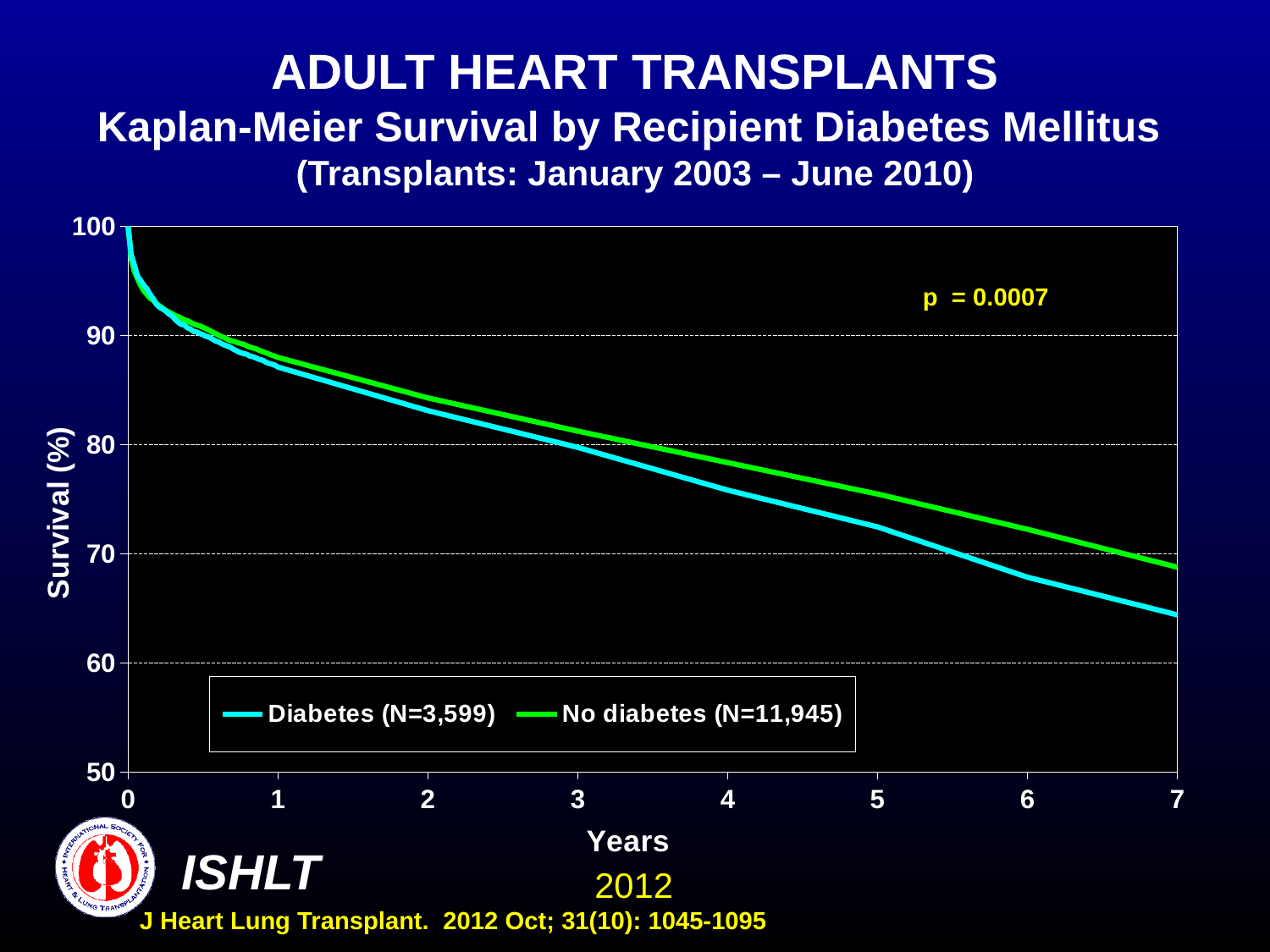
How many series does the legend list? 2 Is the survival for the Diabetes group at 7 years greater or less than 70? less Do the survival curves rise or fall as years increase? fall Is the survival for the Diabetes group at 1 year greater or less than 80? greater Which series has the higher survival at 7 years, Diabetes or No diabetes? No diabetes What kind of chart is shown on the slide? line chart Is the survival for the Diabetes group at 6 years greater or less than 60? greater Which series has the lower survival at 5 years? Diabetes (N=3,599) What p-value is shown on the chart? p = 0.0007 What is the N for the Diabetes group in the legend? 3,599